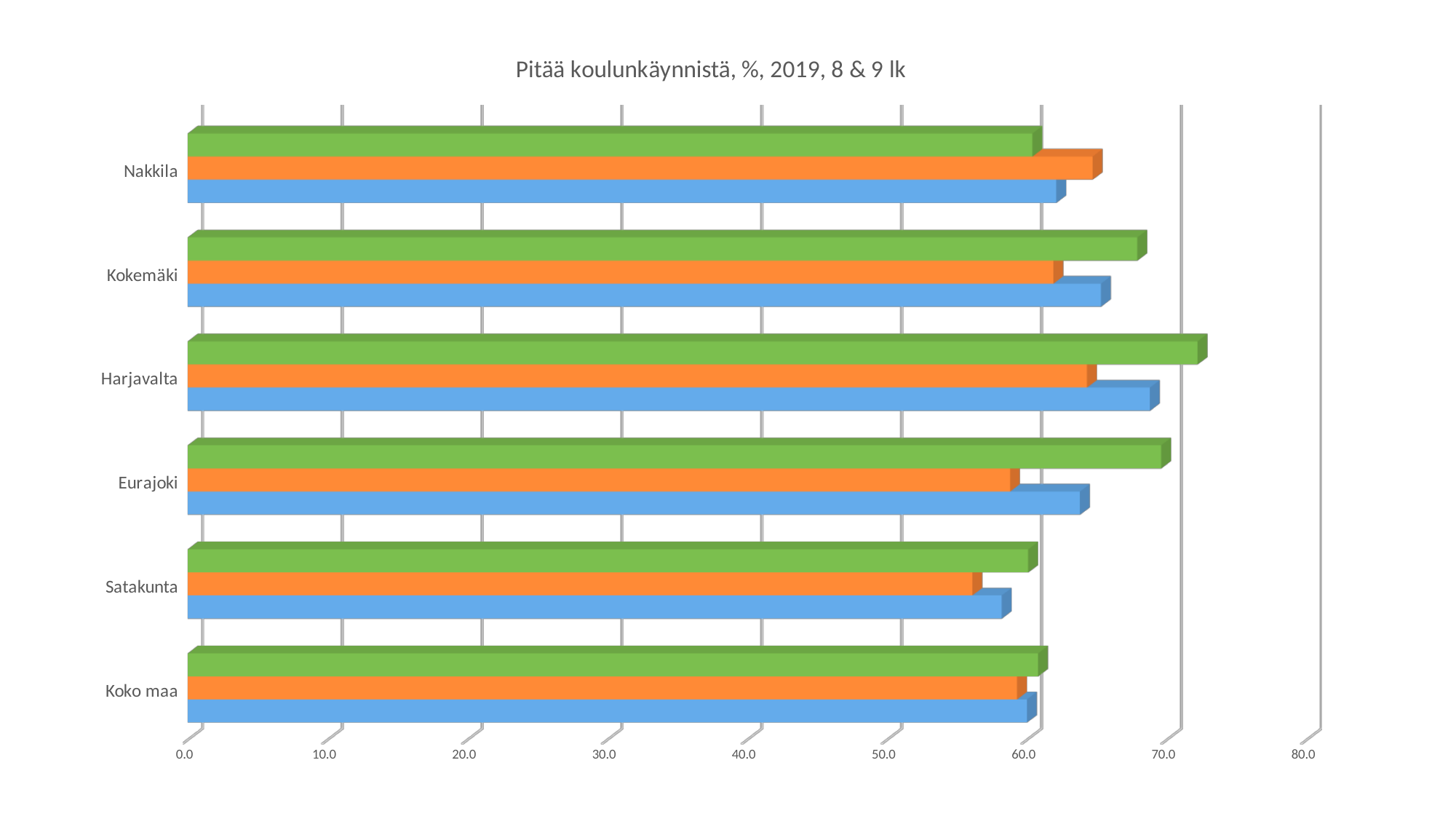
Is the value of the orange bar for Satakunta greater or less than 60.0? less Which category has the longest green bar? Harjavalta Is the value of the orange bar for Nakkila greater or less than 60.0? greater How many categories are shown on the vertical axis of the chart? 6 For Nakkila, which is larger: the green bar or the orange bar? the orange bar What kind of chart is shown on the slide? bar chart For Kokemäki, which is larger: the green bar or the blue bar? the green bar Is the value of the blue bar for Kokemäki greater or less than 60.0? greater Which category has the longest blue bar? Harjavalta What is the title of the chart? Pitää koulunkäynnistä, %, 2019, 8 & 9 lk Which category has the shortest orange bar? Satakunta